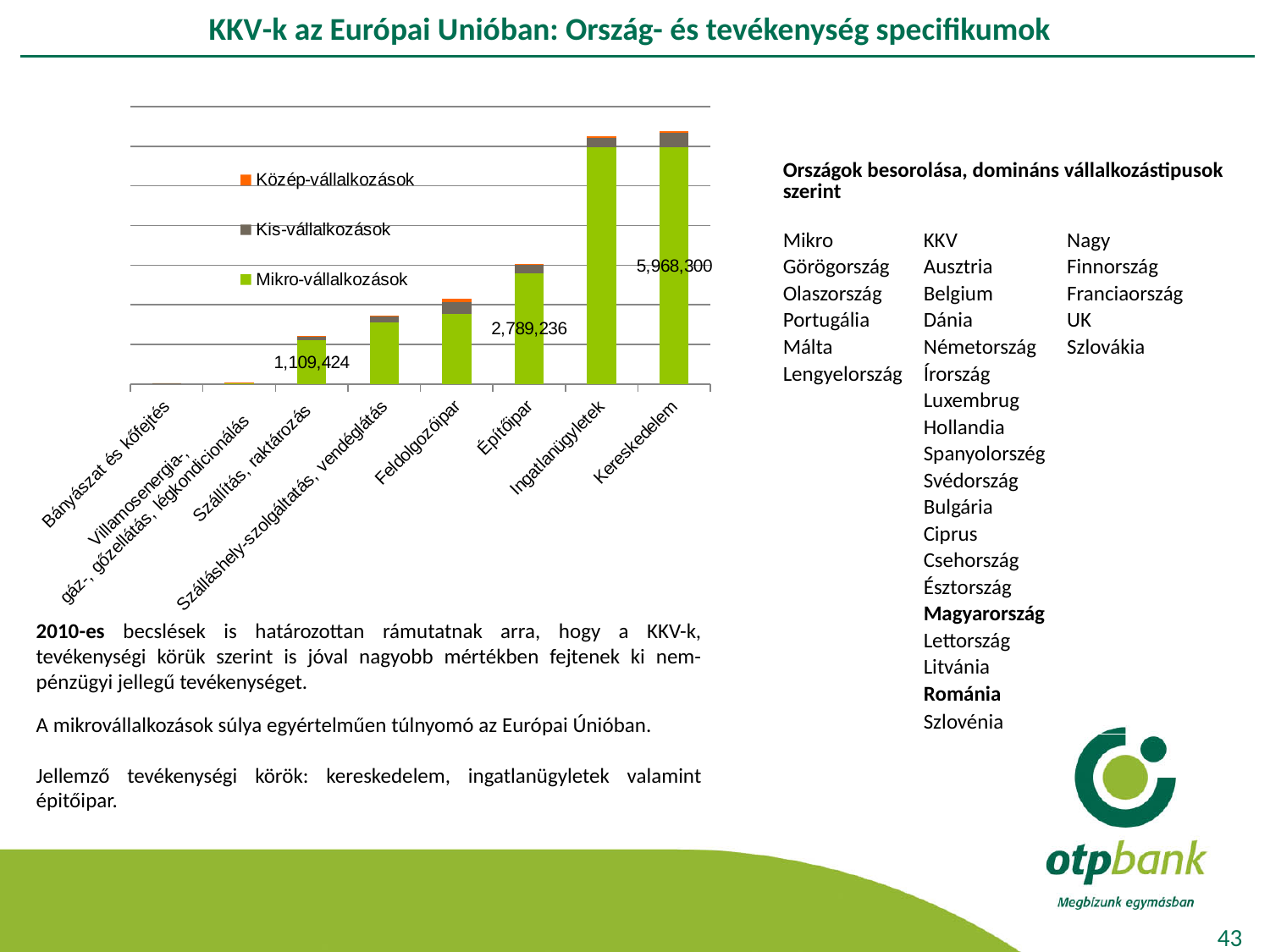
What value is printed as the data label for Kereskedelem? 5,968,300 Which legend entry is shown in green? Mikro-vállalkozások What kind of chart is shown on the slide? Stacked bar chart What is the difference between the printed values for Kereskedelem (5,968,300) and Építőipar (2,789,236)? 3,179,064 How many categories are shown on the x axis of the chart? 8 Which category has the smallest bar in the chart? Bányászat és kőfejtés What value is printed as the data label for Szállítás, raktározás? 1,109,424 Which category has the tallest bar in the chart? Kereskedelem Which bar is taller, Ingatlanügyletek or Építőipar? Ingatlanügyletek Do the bar heights rise or fall moving from left to right along the x axis? Rise What value is printed as the data label for Építőipar? 2,789,236 How many series does the chart legend list? 3